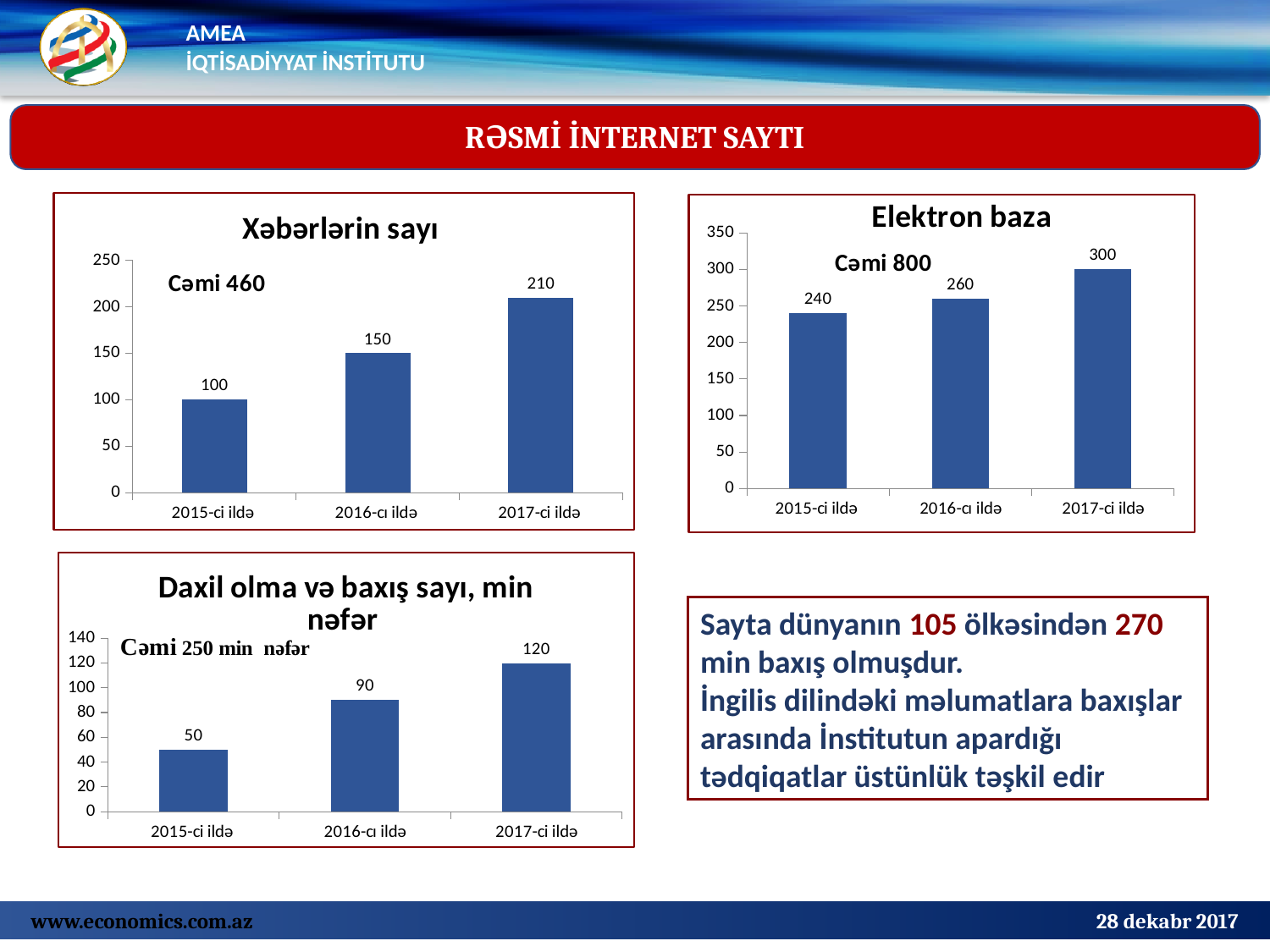
In the 'Xəbərlərin sayı' chart, which year has the highest value? 2017-ci ildə In the 'Elektron baza' chart, what is the difference between the values for 2017-ci ildə and 2016-cı ildə? 40 In the 'Daxil olma və baxış sayı, min nəfər' chart, do the values rise or fall from 2015 to 2017? rise What kind of chart is the 'Elektron baza' chart? bar chart In the 'Xəbərlərin sayı' chart, what is the difference between the values for 2017-ci ildə and 2015-ci ildə? 110 How many categories are shown in the 'Xəbərlərin sayı' chart? 3 In the 'Daxil olma və baxış sayı, min nəfər' chart, what is the value for 2017-ci ildə? 120 In the 'Xəbərlərin sayı' chart, what is the value for 2016-cı ildə? 150 In the 'Daxil olma və baxış sayı, min nəfər' chart, which is larger, the value for 2015-ci ildə or 2016-cı ildə? 2016-cı ildə In the 'Elektron baza' chart, what is the value for 2015-ci ildə? 240 What total is stated inside the 'Xəbərlərin sayı' chart? Cəmi 460 In the 'Elektron baza' chart, which year has the lowest value? 2015-ci ildə